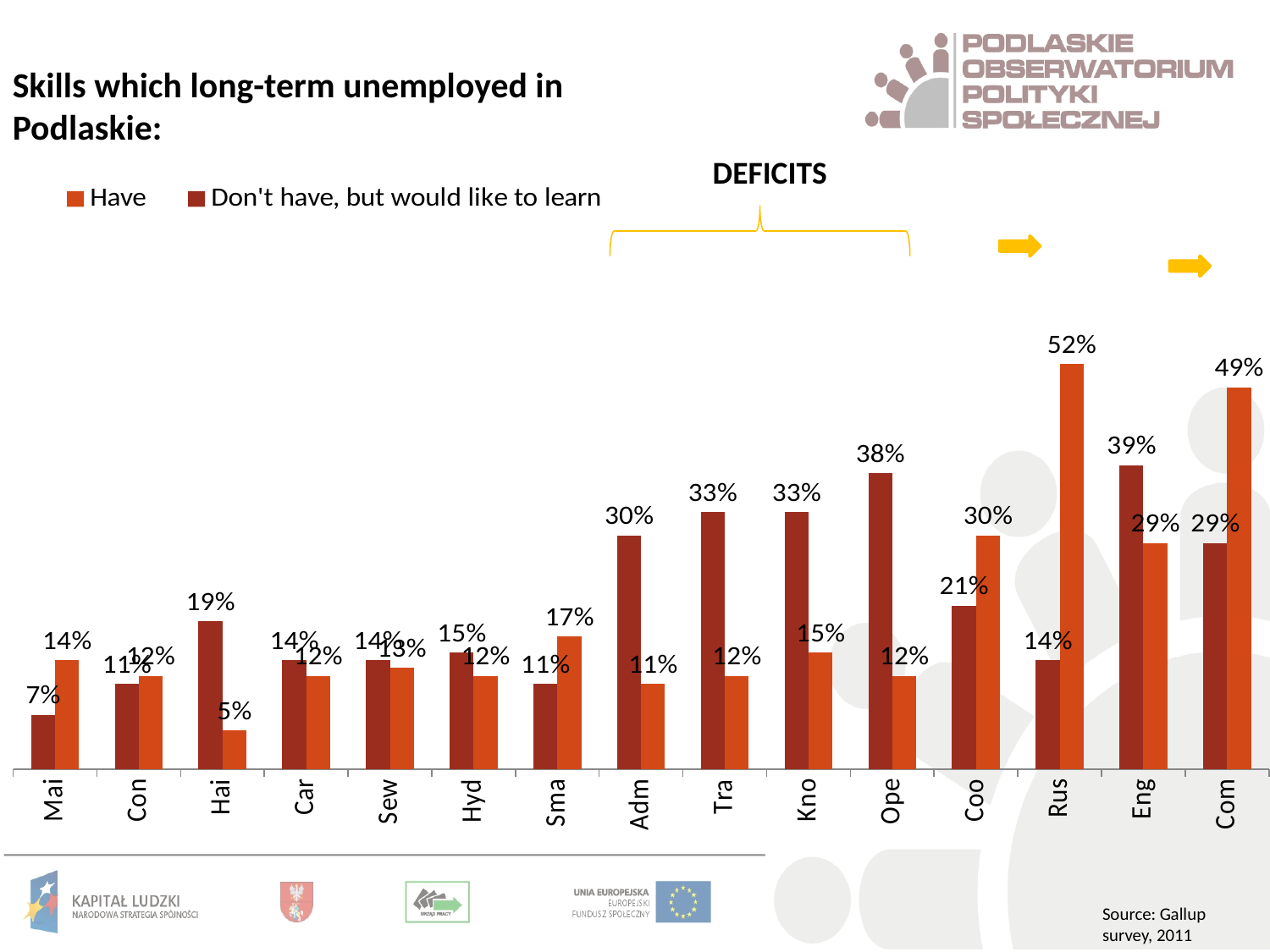
Which category has the highest 'Have' value? Rus What is the difference between the 'Have' and 'Don't have, but would like to learn' values for the category labelled Com? 20% For the category labelled Eng, which is larger: the 'Have' value or the 'Don't have, but would like to learn' value? Don't have, but would like to learn How many categories are shown on the x axis? 15 Which legend entry is shown in the darker red colour? Don't have, but would like to learn How many series does the legend list? 2 What is the 'Don't have, but would like to learn' value for the category labelled Ope? 38% What kind of chart is shown on the slide? bar chart What is the 'Have' value for the category labelled Hai? 5% Which category has the highest 'Don't have, but would like to learn' value? Eng Which category has the lowest 'Don't have, but would like to learn' value? Mai What is the 'Have' value for the category labelled Rus? 52%